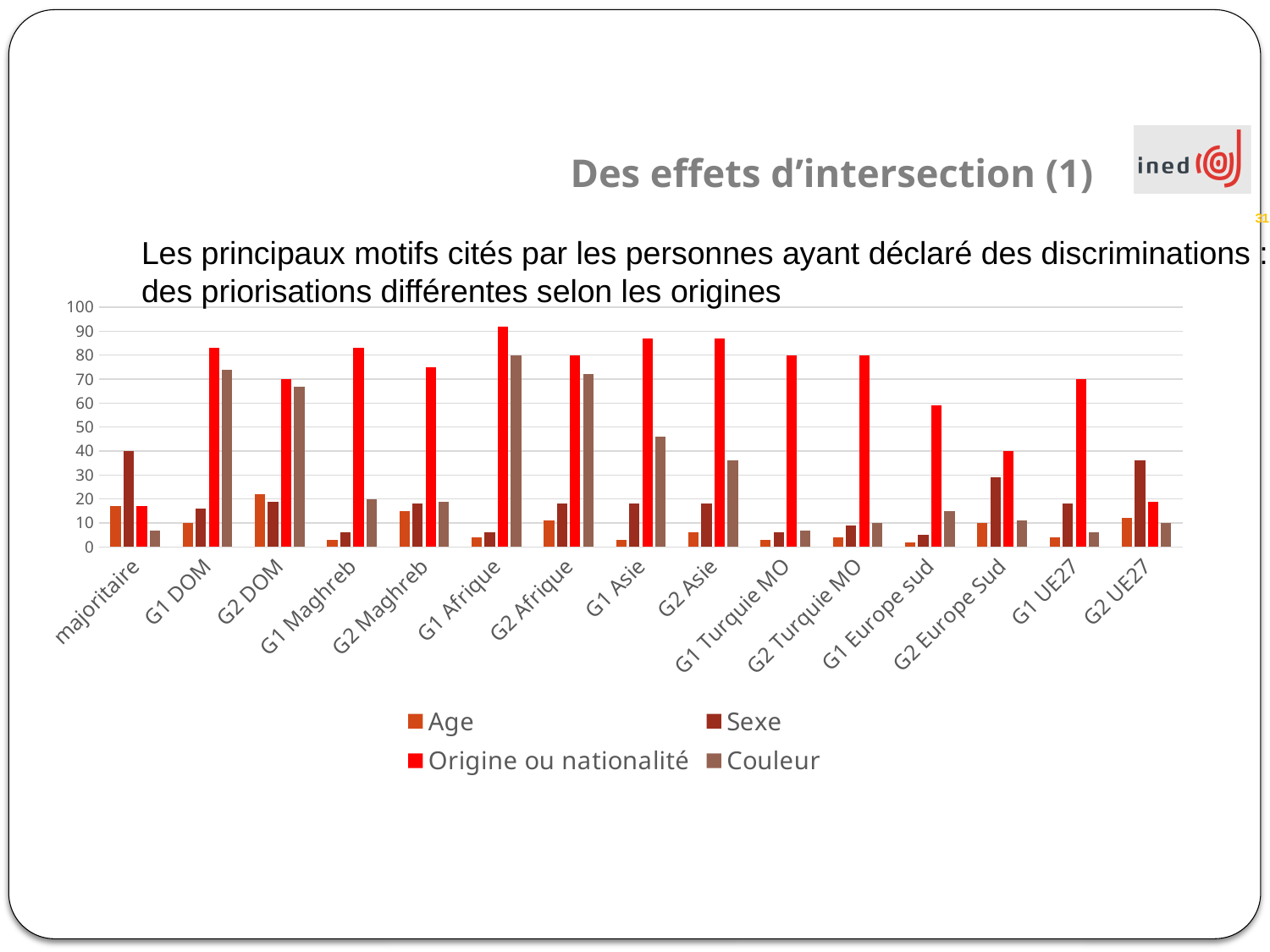
Is the value for Couleur for G1 DOM greater or less than 70? greater For G1 Asie, which is larger: Origine ou nationalité or Couleur? Origine ou nationalité Which series is shown in bright red in the legend? Origine ou nationalité For majoritaire, which is larger: Age or Sexe? Sexe How many series does the legend list? 4 Is the value for Couleur for majoritaire greater or less than 10? less Is the value for Origine ou nationalité for G1 Afrique greater or less than 80? greater How many origin categories are shown on the x axis? 15 Which category has the highest value for Couleur? G1 Afrique What kind of chart is shown on the slide? bar chart Which category has the highest value for Origine ou nationalité? G1 Afrique